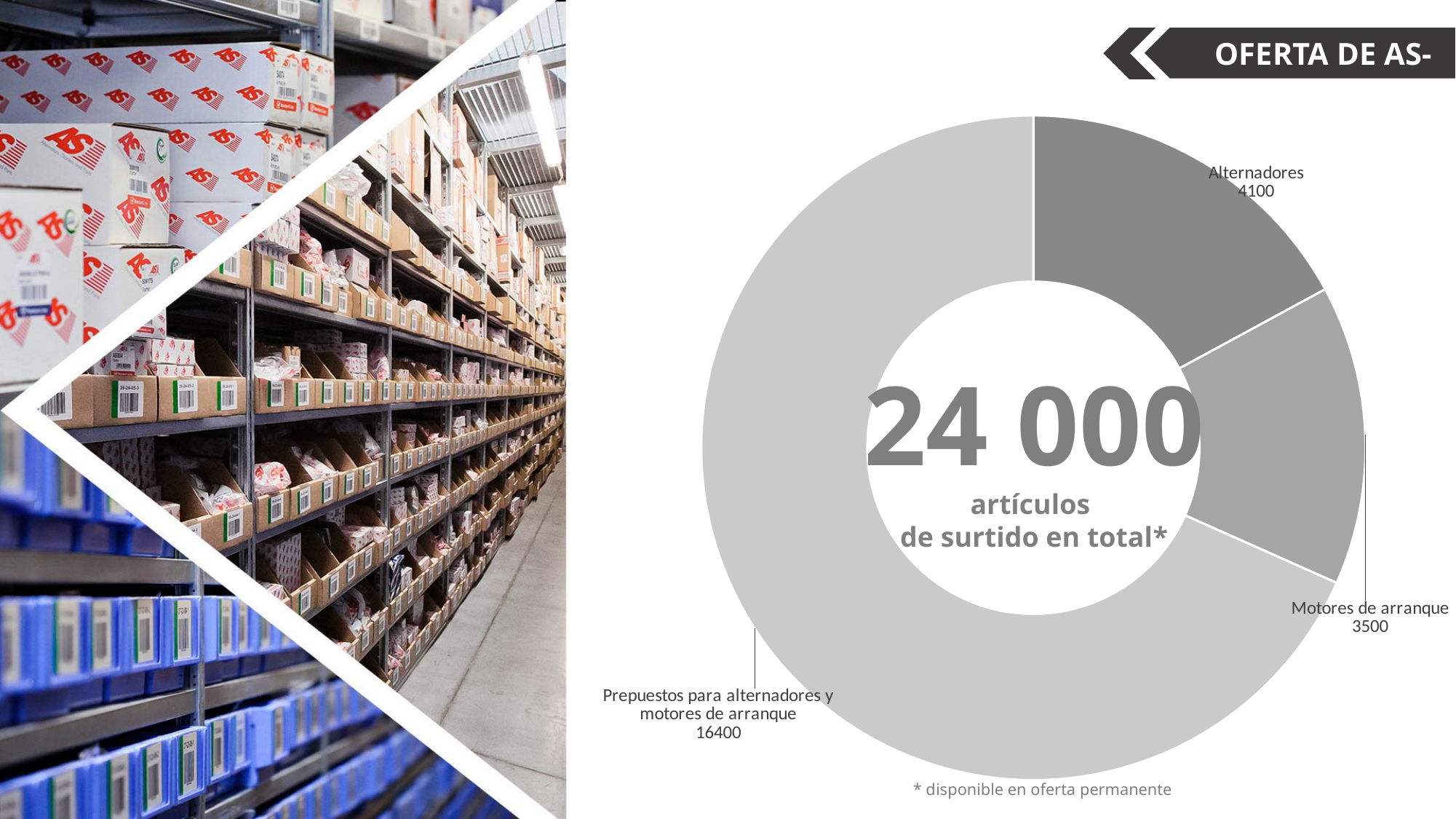
What share of the total does Alternadores represent? 17.1% Which category has the largest value? Prepuestos para alternadores y motores de arranque How many categories does the chart show? 3 What is the difference between the values for Prepuestos para alternadores y motores de arranque and Alternadores? 12300 What total number of items is shown in the centre of the chart? 24 000 What is the value for Alternadores? 4100 What kind of chart is shown on the slide? Doughnut chart What is the difference between the values for Alternadores and Motores de arranque? 600 What is the value for Motores de arranque? 3500 What is the value for Prepuestos para alternadores y motores de arranque? 16400 Which category has the smallest value? Motores de arranque Which is larger, the value for Alternadores or the value for Motores de arranque? Alternadores